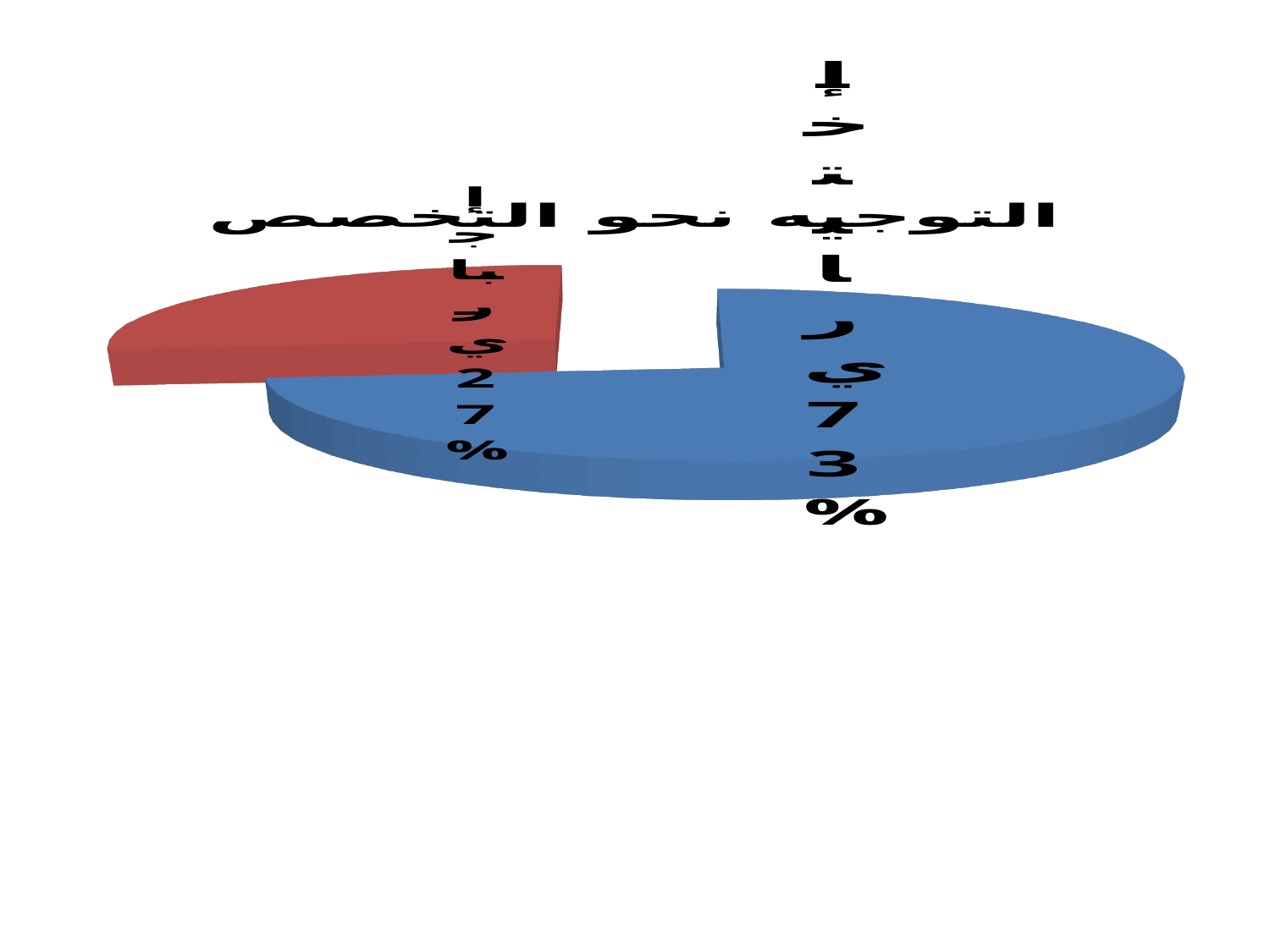
How many slices does the pie chart have? 2 Which slice is the largest in the pie chart? إختياري What percentage is shown for the إجباري slice? 27% What colour is the إختياري slice? blue Is the value for إجباري greater or less than 50%? less What percentage is shown for the إختياري slice? 73% Which is larger, the إختياري slice or the إجباري slice? إختياري What is the title of the chart? التوجيه نحو التخصص Which slice is the smallest in the pie chart? إجباري What is the difference in percentage points between the إختياري slice and the إجباري slice? 46 What kind of chart is shown on the slide? pie chart